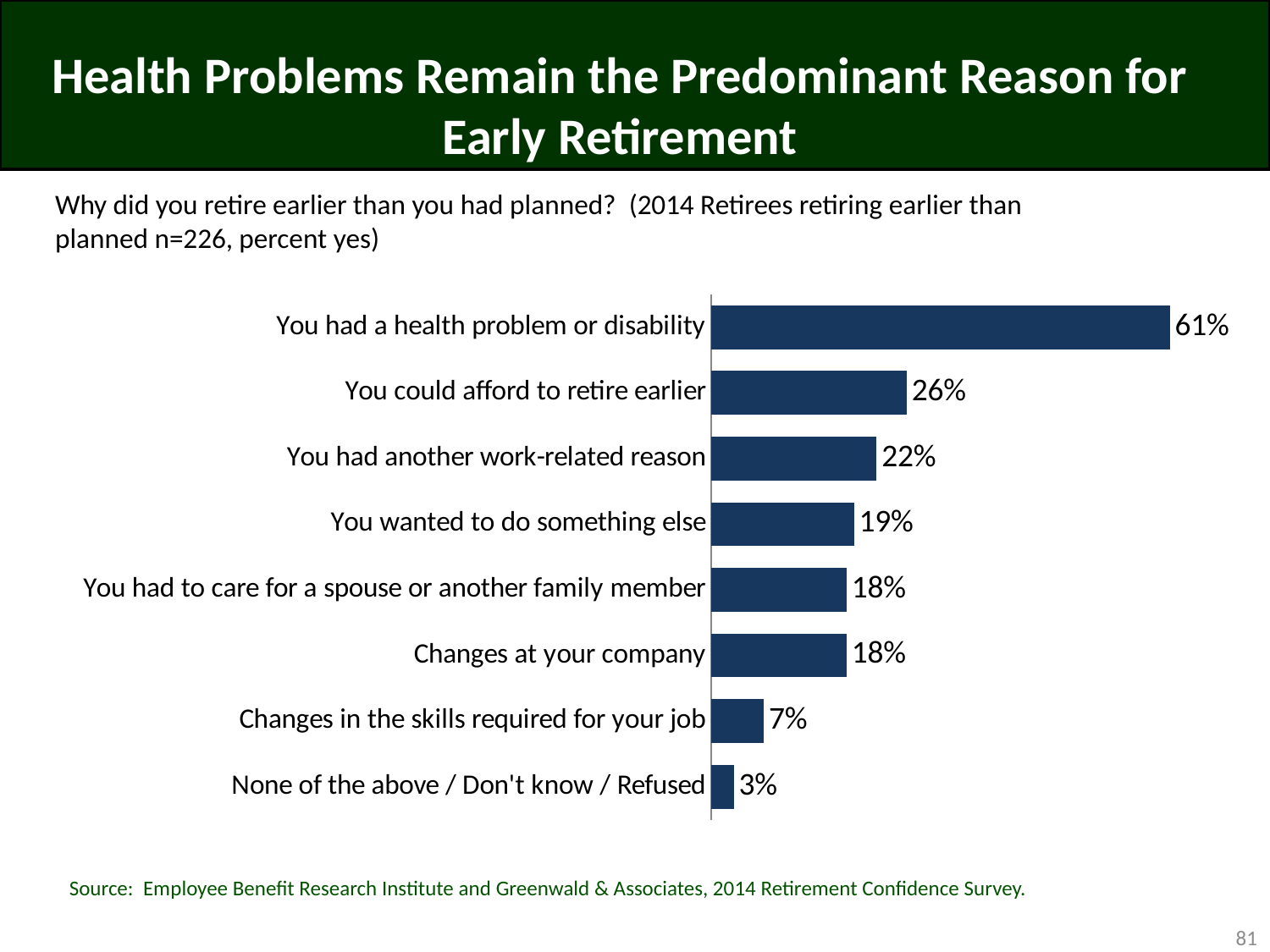
Which reason has the highest percentage? You had a health problem or disability What kind of chart is shown on the slide? Bar chart Which is larger: "You could afford to retire earlier" or "Changes at your company"? You could afford to retire earlier How many categories are shown in the chart? 8 What is the difference between "You had another work-related reason" and "You wanted to do something else"? 3% What is the value for "You could afford to retire earlier"? 26% What percentage cited changes in the skills required for their job? 7% What is the difference between "You had a health problem or disability" and "You could afford to retire earlier"? 35% What is the value for "None of the above / Don't know / Refused"? 3% Which category has the lowest percentage? None of the above / Don't know / Refused What is the sample size (n) stated in the chart subtitle? 226 What percentage of early retirees said they had a health problem or disability? 61%